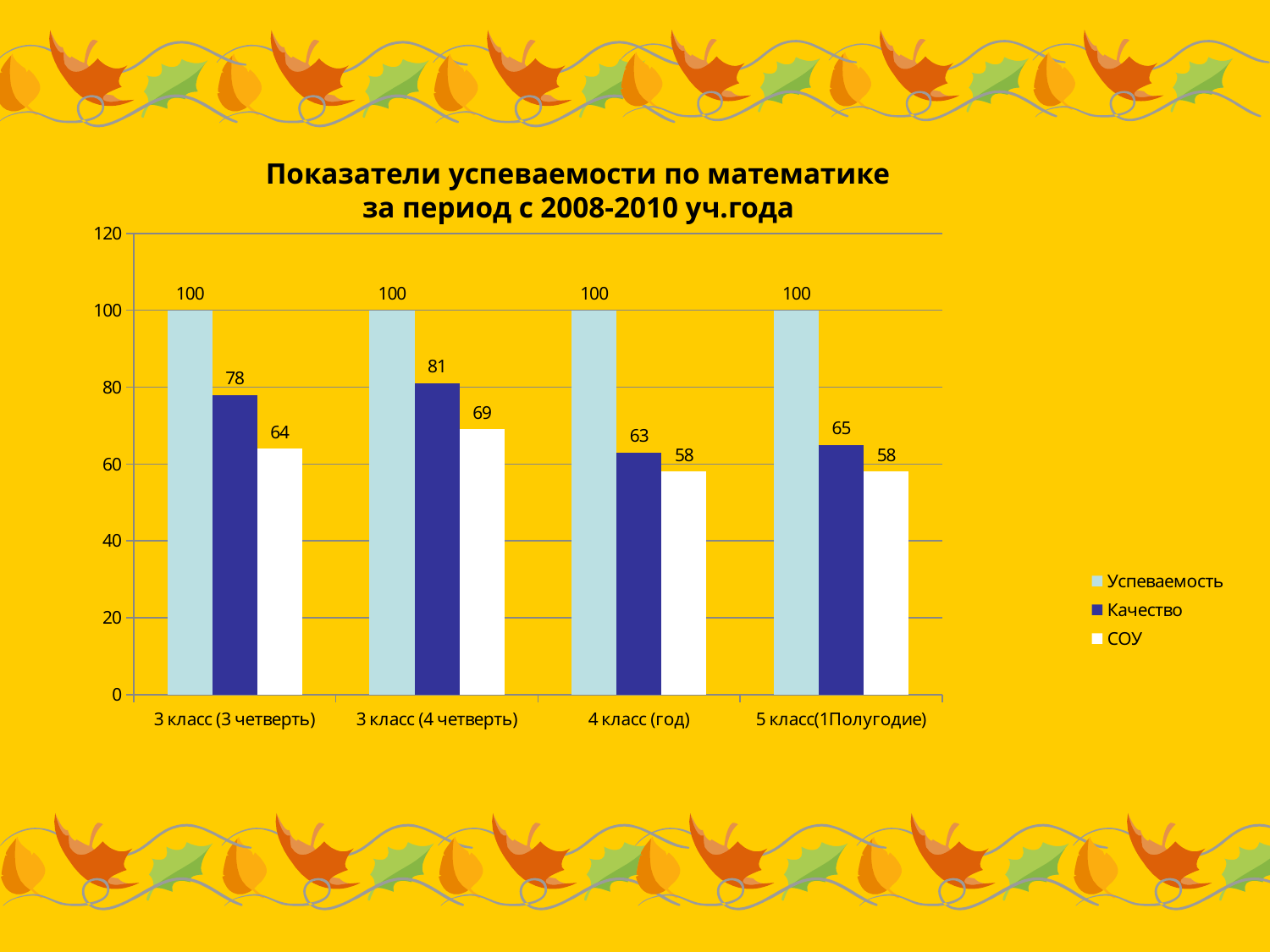
How many categories are shown on the x axis? 4 Which is larger: СОУ for 3 класс (4 четверть) or СОУ for 5 класс(1Полугодие)? 3 класс (4 четверть) What is the title of the chart? Показатели успеваемости по математике за период с 2008-2010 уч.года What is the difference between Качество and СОУ for 3 класс (3 четверть)? 14 Which category has the highest Качество value? 3 класс (4 четверть) What is the value of СОУ for 3 класс (3 четверть)? 64 What kind of chart is shown on the slide? bar chart What is the value of Успеваемость for 4 класс (год)? 100 What is the value of Качество for 3 класс (4 четверть)? 81 How many series does the legend list? 3 Which category has the lowest Качество value? 4 класс (год) What is the value of Качество for 5 класс(1Полугодие)? 65